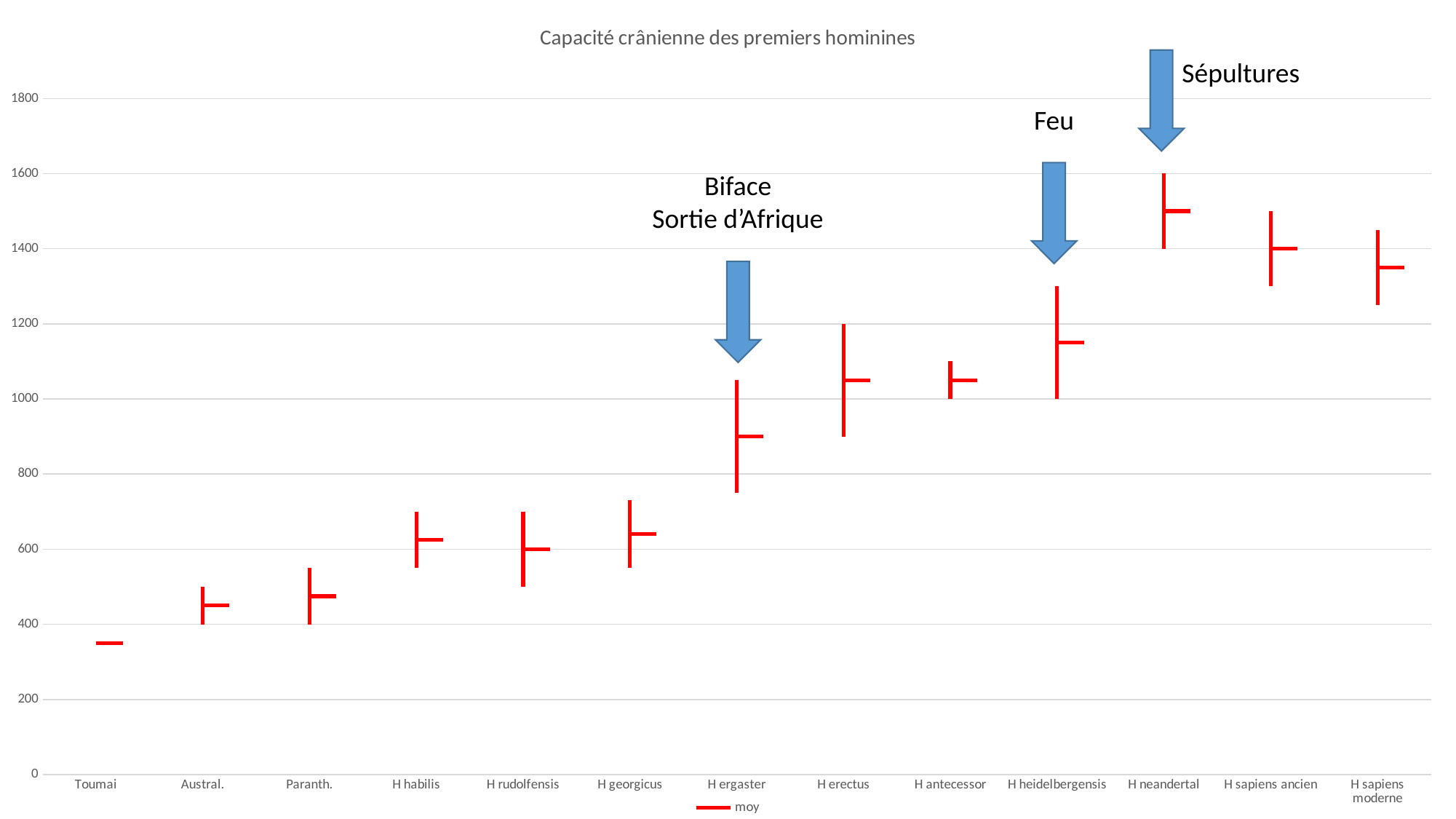
What is the name of the series shown in the chart legend? moy Which category has the highest value in the chart? H neandertal Is the mean (moy) value for H ergaster greater or less than 1000? less What is the title of the chart? Capacité crânienne des premiers hominines Do the values generally rise or fall from left to right along the x axis? rise Is the value for Toumai greater or less than 400? less Is the mean (moy) value for H heidelbergensis greater or less than 1200? less Which category has the lowest value in the chart? Toumai How many categories are shown on the x axis of the chart? 13 Which has a larger value, H neandertal or H sapiens moderne? H neandertal How many series does the chart legend list? 1